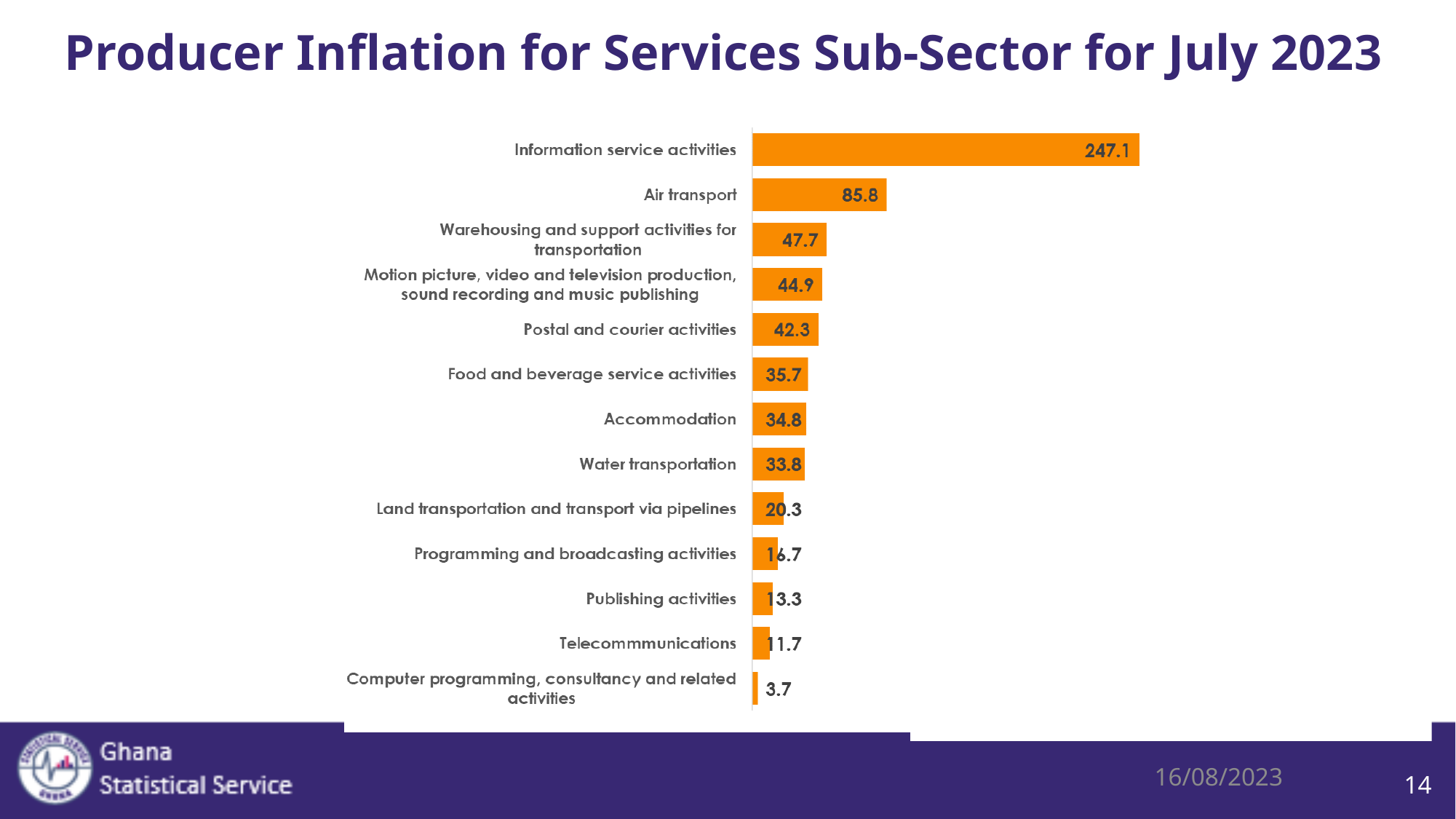
What is the difference between the values for Warehousing and support activities for transportation and Water transportation? 13.9 How many sub-sectors are shown in the chart? 13 What kind of chart is shown on the slide? Bar chart What colour are the bars in the chart? Orange What is the producer inflation value for Information service activities? 247.1 Which sub-sector has the lowest producer inflation? Computer programming, consultancy and related activities What is the difference between the values for Information service activities and Air transport? 161.3 What is the value shown for Air transport? 85.8 What is the value for Postal and courier activities? 42.3 Which has a larger value, Accommodation or Land transportation and transport via pipelines? Accommodation Which sub-sector has the highest producer inflation? Information service activities What is the value for Telecommmunications? 11.7